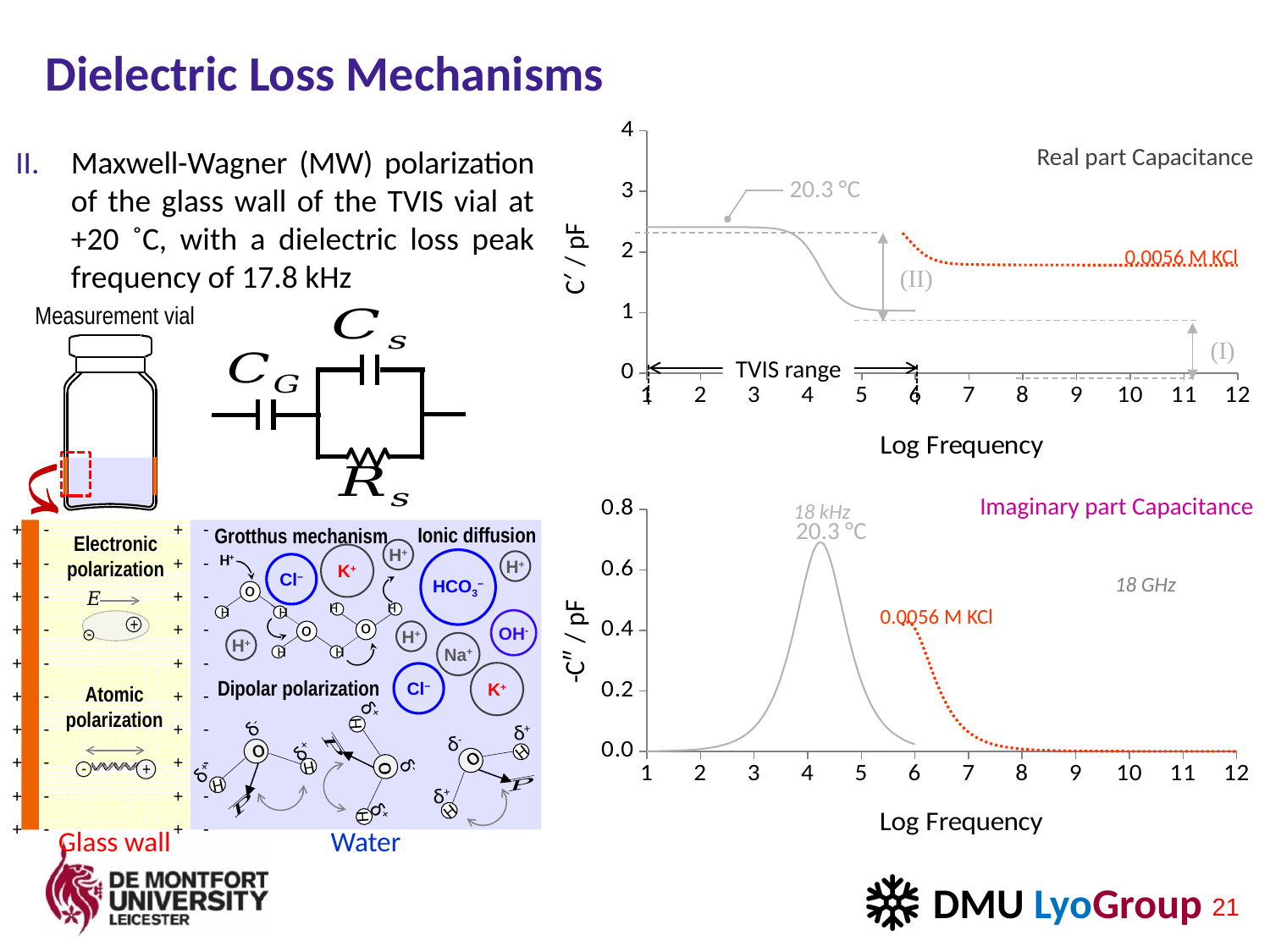
In the Real part Capacitance chart, is the value of the 20.3 °C line at log frequency 5.5 greater or less than 2? less In the Imaginary part Capacitance chart, at log frequency 6, which line has the larger value, 20.3 °C or 0.0056 M KCl? 0.0056 M KCl In the Imaginary part Capacitance chart, what is the label on the y axis? -C″ / pF What kind of chart is the Real part Capacitance chart? line chart In the Imaginary part Capacitance chart, is the value of the 0.0056 M KCl line at log frequency 8 greater or less than 0.2? less In the Real part Capacitance chart, does the 20.3 °C line rise or fall between log frequency 3 and log frequency 5? fall In the Real part Capacitance chart, is the value of the 20.3 °C line at log frequency 2 greater or less than 2? greater How many tick marks are labelled on the x axis of the Imaginary part Capacitance chart? 12 In the Imaginary part Capacitance chart, does the 20.3 °C line rise or fall between log frequency 5 and log frequency 6? fall In the Real part Capacitance chart, what is the label on the x axis? Log Frequency